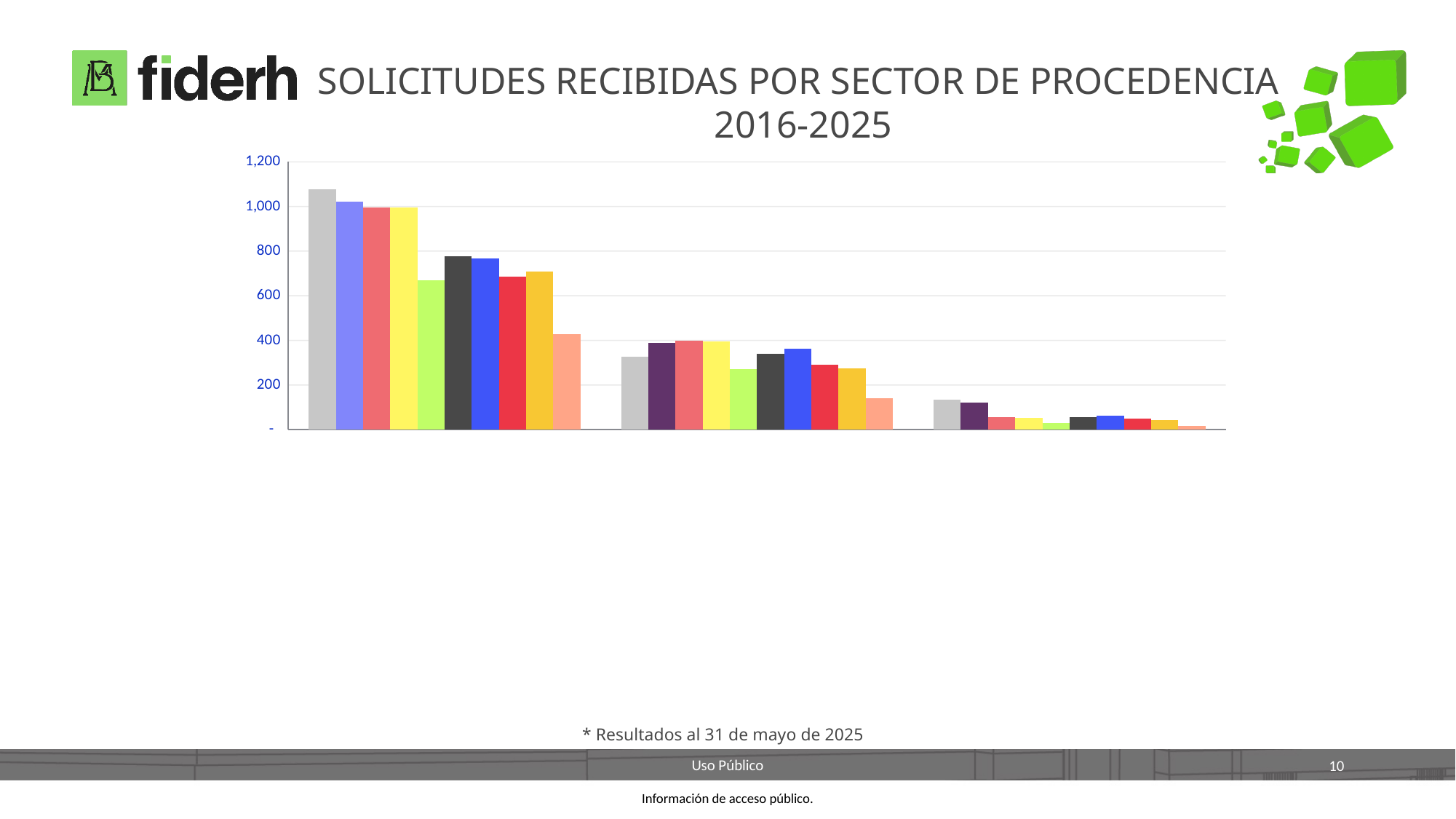
How many groups of bars does the chart show? 3 Is the first (grey) bar in the middle group greater or less than 400? less Is the shortest bar in the leftmost group greater or less than 600? less What kind of chart is shown on the slide? bar chart Is the tallest bar in the middle group greater or less than 600? less Which group of bars has the lowest values overall: the leftmost, middle or rightmost? rightmost What is the title of the chart on the slide? SOLICITUDES RECIBIDAS POR SECTOR DE PROCEDENCIA 2016-2025 How many bars are in the leftmost group of the chart? 10 Which group of bars contains the tallest bar in the chart: the leftmost, middle or rightmost? leftmost What is the highest value shown on the vertical axis of the chart? 1,200